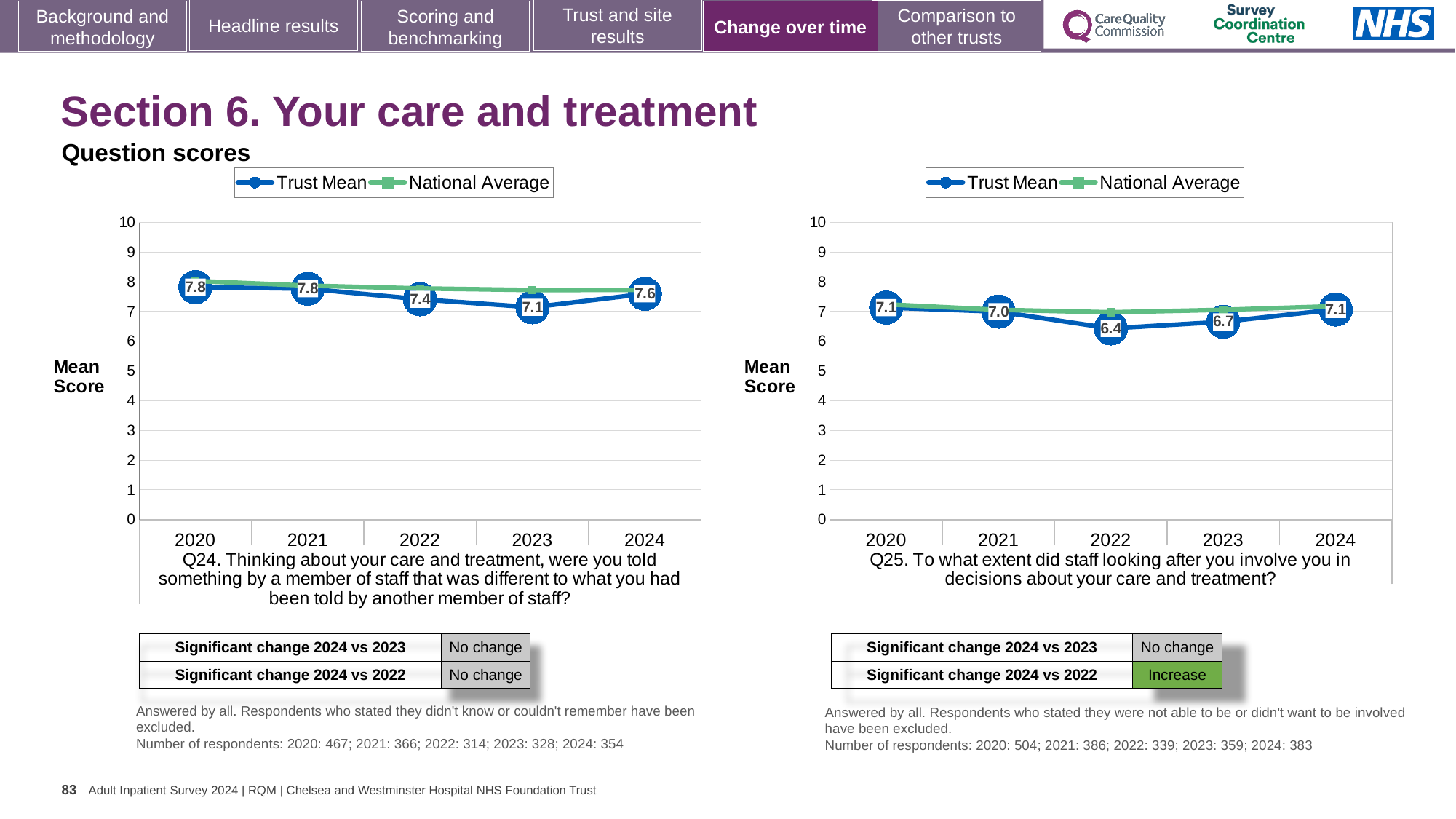
In the Q24 chart on the left, which year has the lowest Trust Mean score? 2023 In the Q24 chart on the left, what is the Trust Mean score for 2023? 7.1 What kind of chart is the Q24 chart on the left? Line chart In the Q25 chart on the right, does the Trust Mean rise or fall from 2022 to 2024? Rise How many series does the legend of the Q25 chart on the right list? 2 In the Q25 chart on the right, what is the difference between the Trust Mean scores for 2024 and 2022? 0.7 In the Q25 chart on the right, is the National Average for 2022 greater or less than 6? greater In the Q24 chart on the left, what is the difference between the Trust Mean scores for 2021 and 2023? 0.7 In the Q25 chart on the right, which year has the lowest Trust Mean score? 2022 How many years are plotted on the x axis of the Q24 chart on the left? 5 In the Q24 chart on the left, is the Trust Mean score higher in 2022 or in 2024? 2024 In the Q25 chart on the right, what is the Trust Mean score for 2022? 6.4